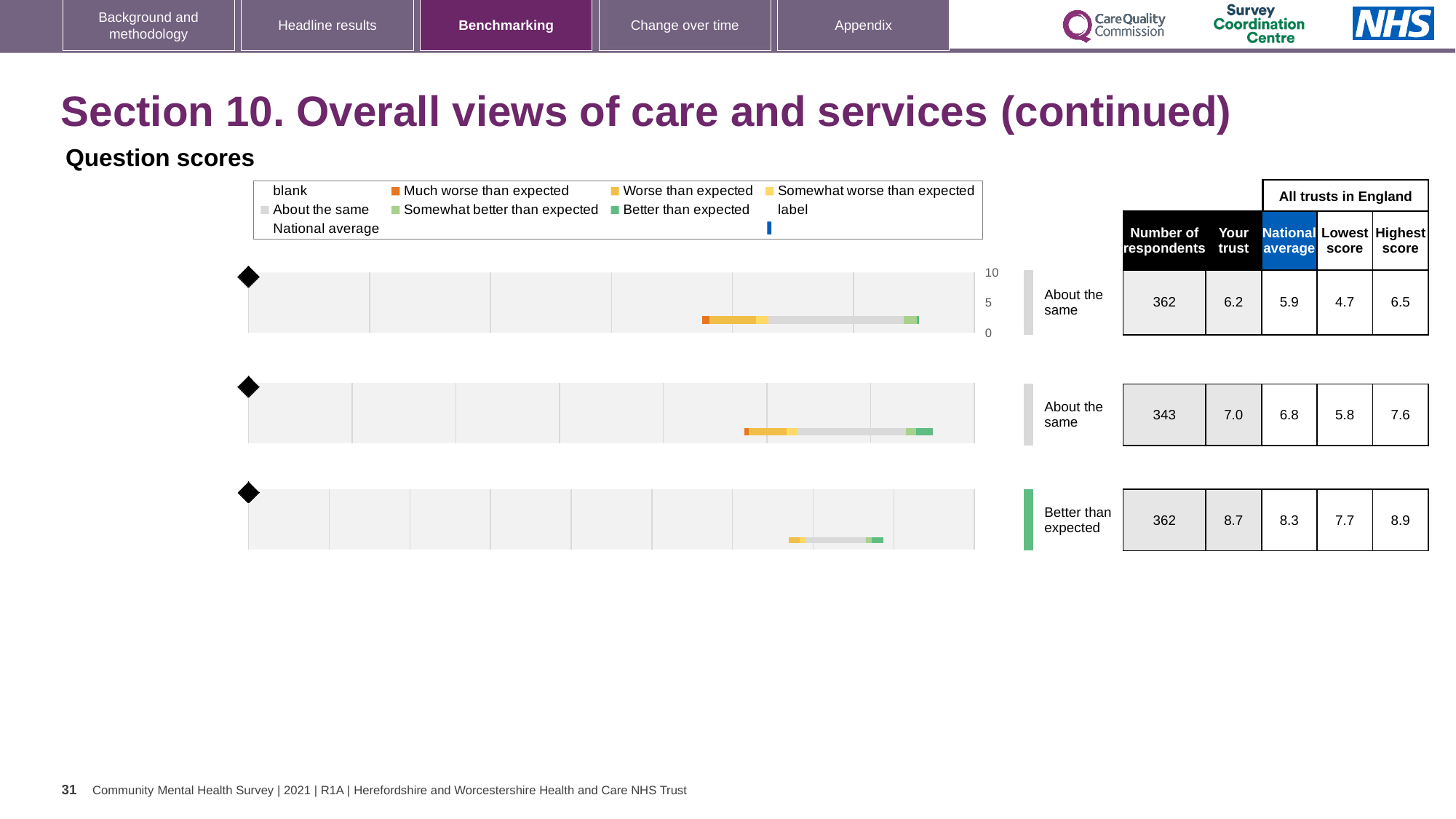
What kind of chart is used to show the question scores on this slide? Bar chart What is the maximum value shown on the score axis of the top chart? 10 What benchmark category is shown next to the bottom chart? Better than expected How many question score charts are shown on the slide? 3 For the middle chart, what is the difference between the 'Your trust' score and the national average? 0.2 Which of the three charts has the highest 'Your trust' score? The bottom chart For the bottom chart, what is the highest score among all trusts in England? 8.9 For the middle chart, how many respondents are there? 343 For the top chart, what is the national average score? 5.9 For the top chart, what is the 'Your trust' score? 6.2 For the top chart, what is the difference between the highest score and the lowest score? 1.8 For the bottom chart, which is larger: the 'Your trust' score or the national average? Your trust